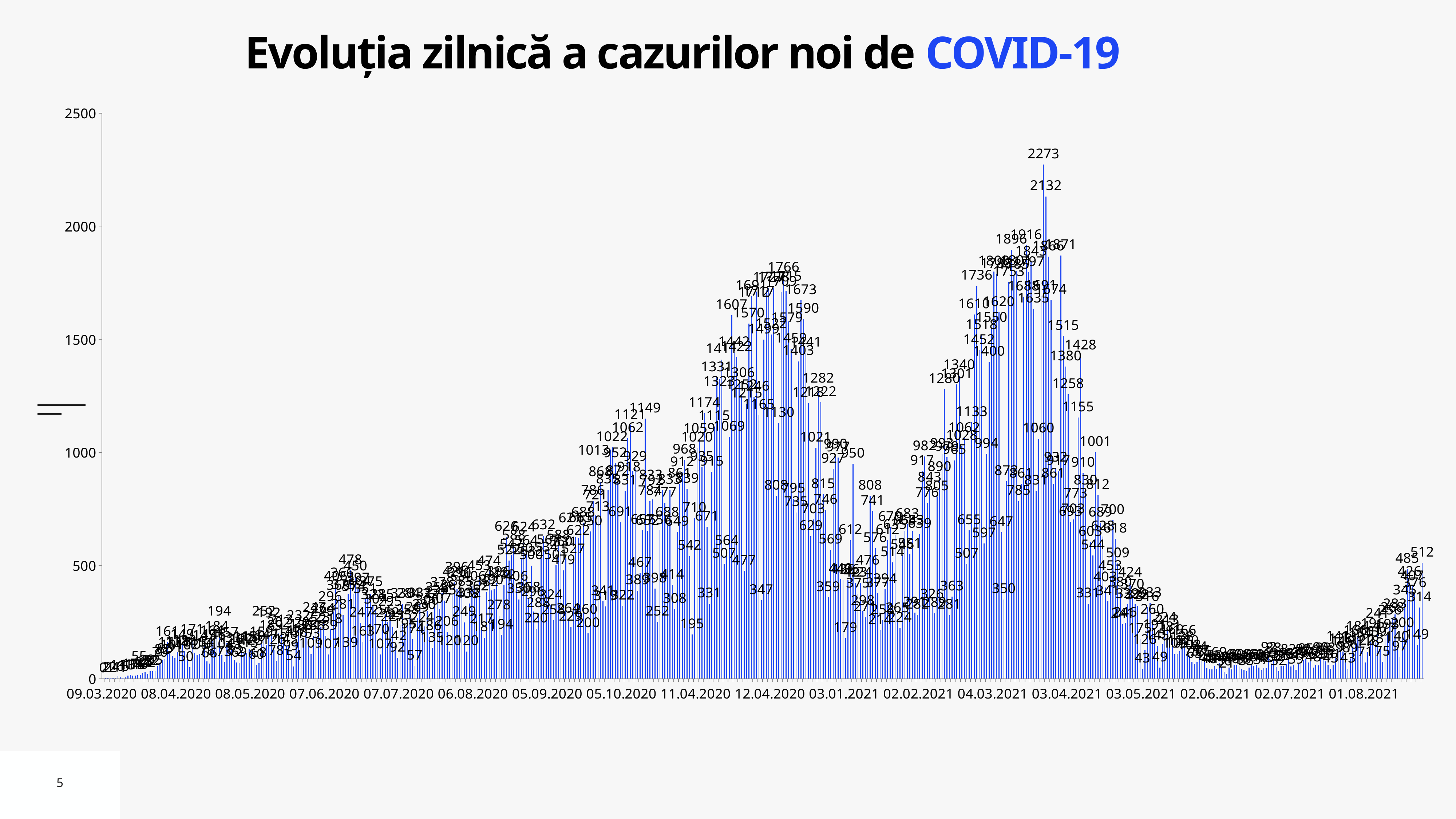
What is the title of the chart? Evoluția zilnică a cazurilor noi de COVID-19 Do the values rise or fall between 03.05.2021 and 02.06.2021? fall Do the values rise or fall between 02.07.2021 and the end of the chart? rise What is the value of the second-tallest bar on the chart? 2132 What is the difference between the two tallest bars, labelled 2273 and 2132? 141 What is the highest daily value labelled on the chart? 2273 Is the highest value on the chart greater or less than 2000? greater What is the highest value shown on the vertical axis? 2500 Which is higher: the tallest bar near 12.04.2020 or the tallest bar near 03.04.2021? the tallest bar near 03.04.2021 What is the value labelled on the last (rightmost) bar of the chart? 512 Is the value for the first bar, at 09.03.2020, greater or less than 500? less What kind of chart is shown on the slide? bar chart